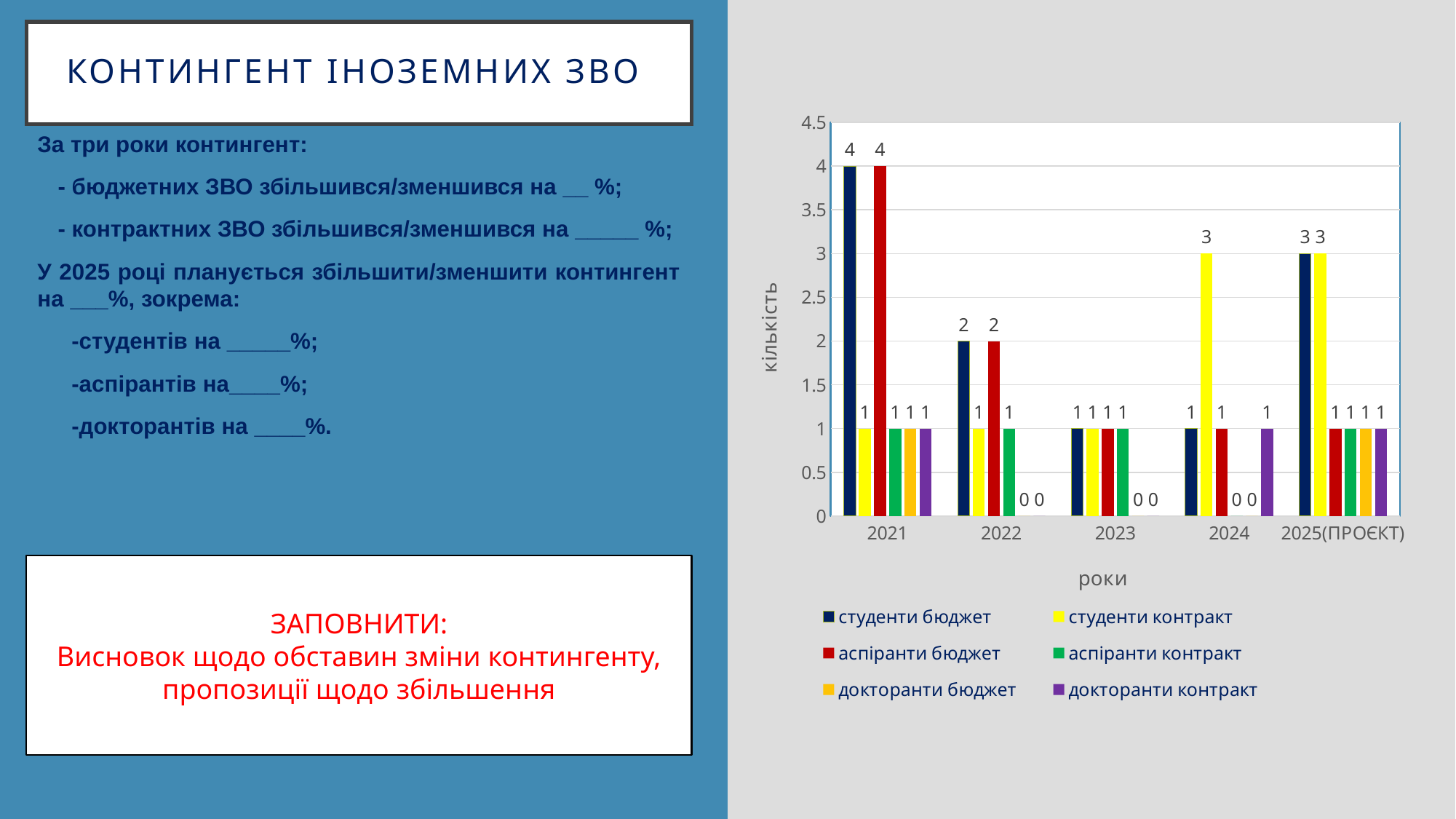
What is the value for аспіранти бюджет in 2022? 2 What is the value for докторанти бюджет in 2023? 0 What kind of chart is shown on the slide? bar chart How many year categories are shown on the x axis of the chart? 5 How many series does the chart legend list? 6 What is the difference between студенти бюджет in 2021 and студенти бюджет in 2022? 2 What is the value for студенти бюджет in 2021? 4 What is the label of the y axis of the chart? кількість What is the value for студенти контракт in 2024? 3 Does the value for студенти бюджет fall or rise from 2021 to 2023? fall In which year is the value for студенти бюджет highest? 2021 Which is larger: студенти контракт in 2024 or студенти бюджет in 2024? студенти контракт in 2024